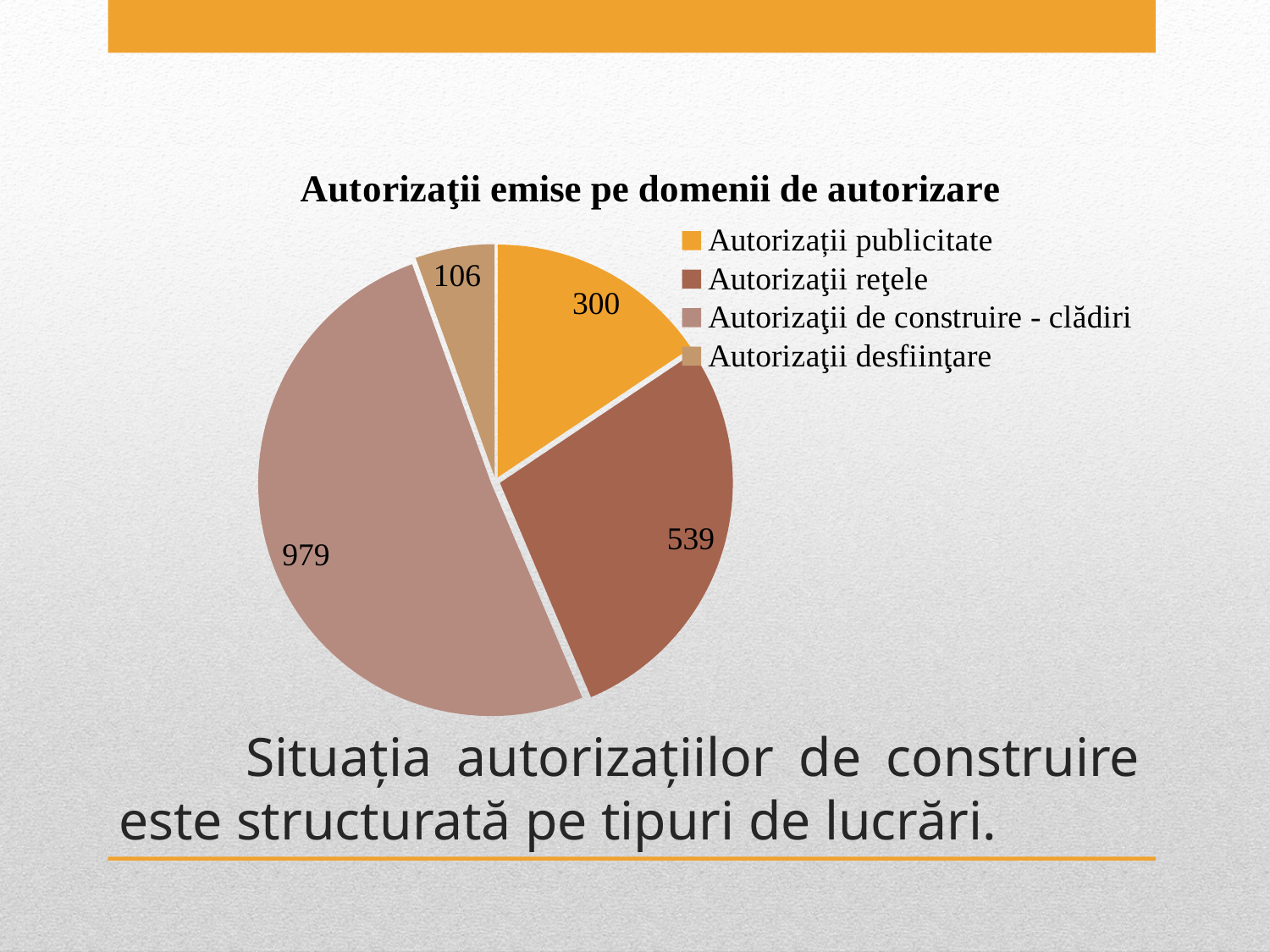
What is the value for Autorizaţii desfiinţare? 106 How many slices does the pie chart have? 4 Which category has the largest slice? Autorizaţii de construire - clădiri Which is larger, Autorizaţii reţele or Autorizații publicitate? Autorizaţii reţele What is the value for Autorizaţii reţele? 539 What type of chart is shown on the slide? Pie chart What is the total of all four slices? 1924 What is the value for Autorizaţii de construire - clădiri? 979 Which category has the smallest slice? Autorizaţii desfiinţare What is the value for Autorizații publicitate? 300 What is the title of the chart? Autorizaţii emise pe domenii de autorizare What is the difference between the values for Autorizaţii reţele and Autorizații publicitate? 239